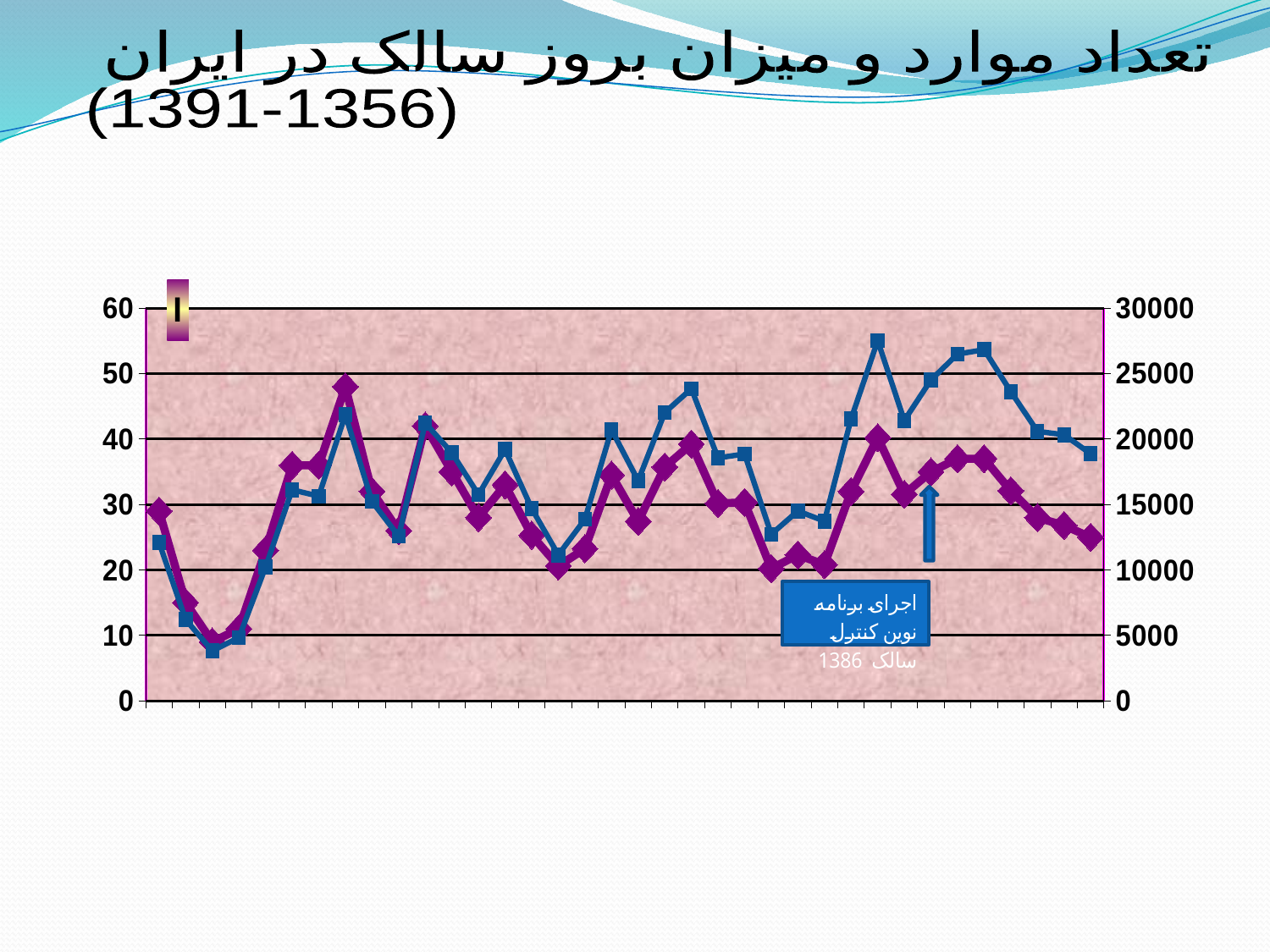
What is the highest value shown on the left vertical axis? 60 At the right end of the chart, which line is plotted higher, the blue square line or the purple diamond line? blue square line What kind of chart is shown on the slide? line chart Read against the left axis, is the last point of the purple diamond line greater or less than 30? less Does the blue square line rise or fall over its final five points at the right end of the chart? fall Read against the left axis, is the last point of the blue square line greater or less than 30? greater What is the highest value shown on the right vertical axis? 30000 Read against the left axis, is the lowest point of the blue square line greater or less than 10? less How many lines are plotted on the chart? 2 Does the purple diamond line rise or fall from its first point to its fourth point? fall